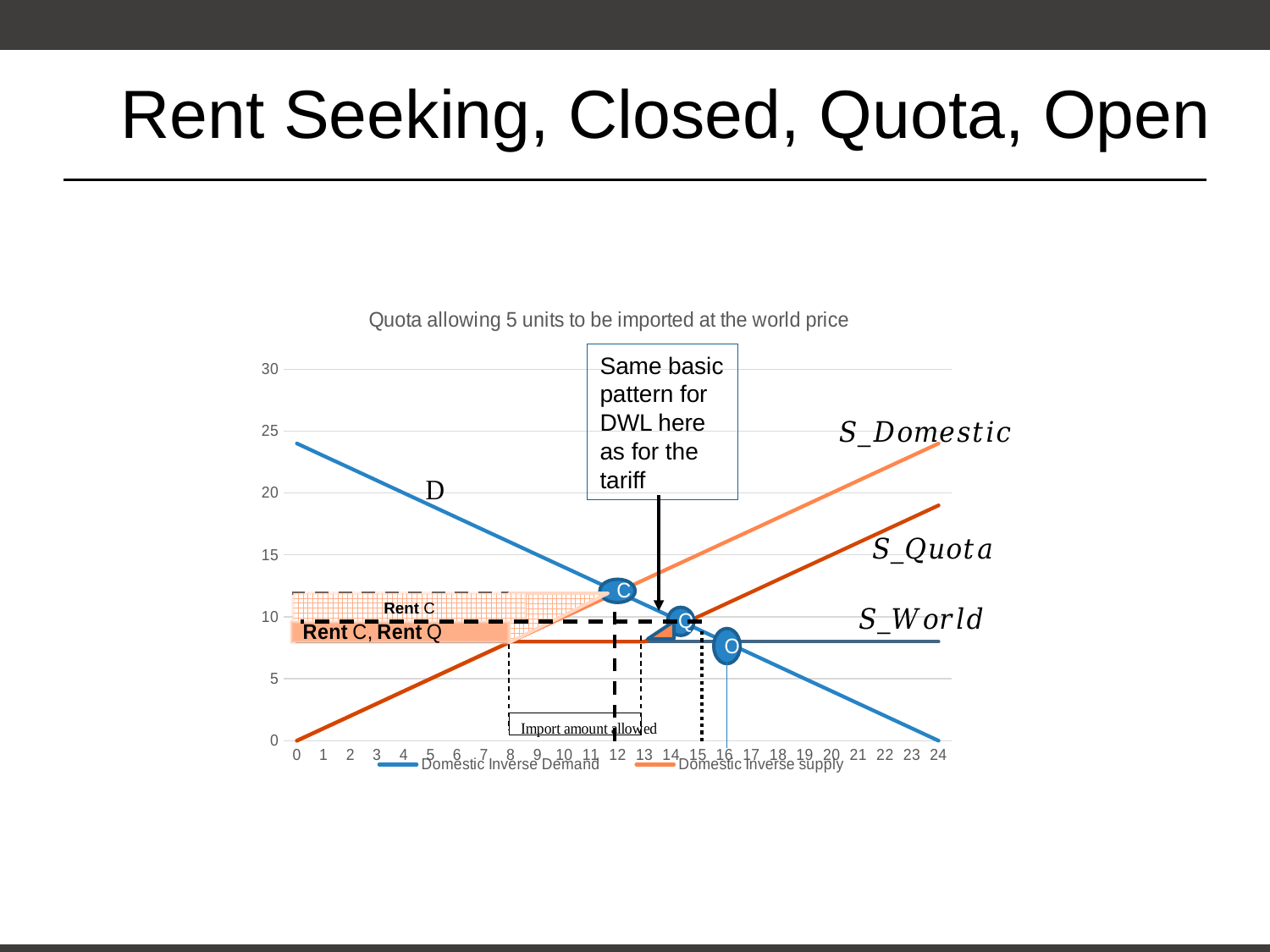
Does the Domestic Inverse Demand line rise or fall as quantity increases along the x axis? fall Does the Domestic Inverse supply line rise or fall as quantity increases along the x axis? rise At quantity 20, which is larger: the Domestic Inverse Demand value or the Domestic Inverse supply value? Domestic Inverse supply Which two series are listed in the chart legend? Domestic Inverse Demand, Domestic Inverse supply Is the S_World price line greater or less than 10? less What is the title of the chart? Quota allowing 5 units to be imported at the world price At quantity 4, which is larger: the Domestic Inverse Demand value or the Domestic Inverse supply value? Domestic Inverse Demand How many series does the chart legend list? 2 What kind of chart is shown on the slide? line chart Is the value of the Domestic Inverse Demand line at quantity 0 greater or less than 20? greater Is the value of the Domestic Inverse supply line at quantity 24 greater or less than 20? greater What is the highest value labelled on the vertical axis? 30